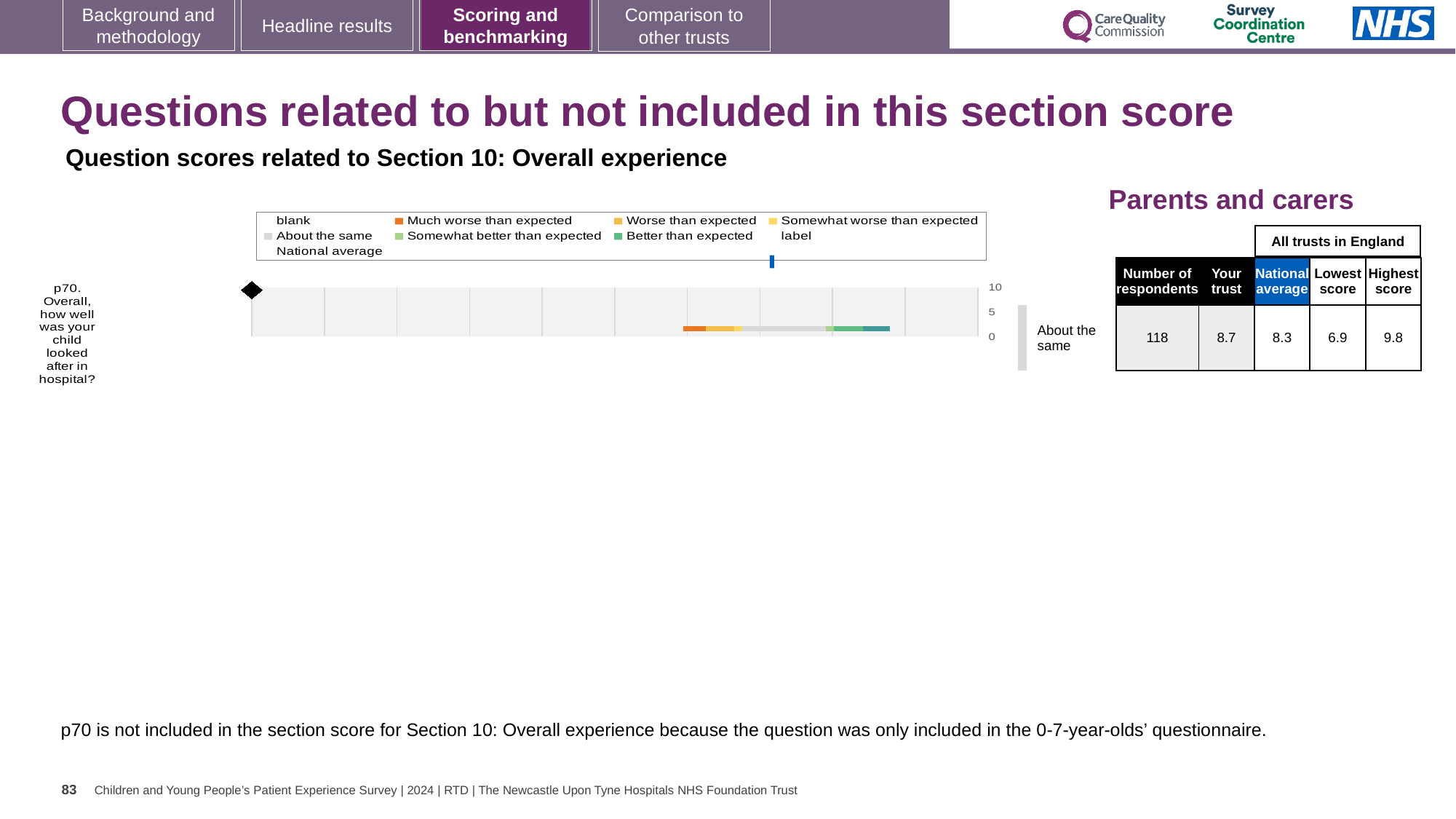
What is the difference between the highest score and the lowest score for p70? 2.9 What is the national average score for p70? 8.3 What is the highest score among all trusts in England for p70? 9.8 What is the 'Your trust' score for p70? 8.7 How many respondents answered p70? 118 Which question is plotted in the chart? p70. Overall, how well was your child looked after in hospital? Which is larger for p70, the 'Your trust' score or the national average? Your trust Which benchmark category does the trust's score for p70 fall into, according to the label next to the chart? About the same What is the lowest score among all trusts in England for p70? 6.9 Is the 'Your trust' score for p70 greater or less than 5? greater How many questions are plotted in the chart? 1 What kind of chart is used to show the p70 question score? Bar chart